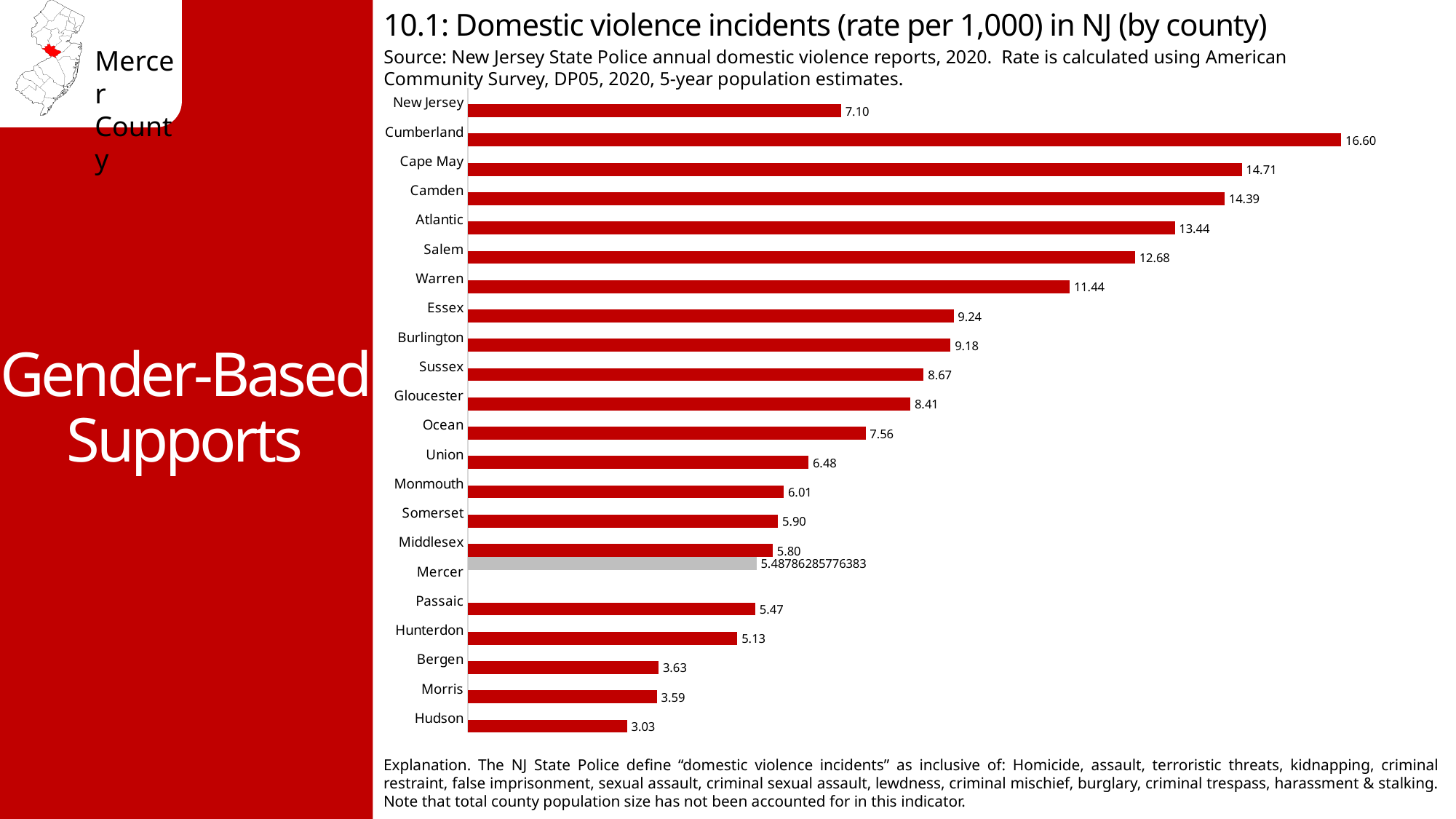
How many bars (counties plus the state total) are plotted in the chart? 22 What is the difference between the rates for Cape May and Camden? 0.32 Which has a higher domestic violence incident rate, Essex or Ocean? Essex What is the difference between the rates for Cumberland and Hudson? 13.57 Which county has the highest domestic violence incident rate in the chart? Cumberland Which bar in the chart is shaded grey instead of red? Mercer What is the domestic violence incident rate per 1,000 shown for New Jersey overall? 7.10 Which has a higher domestic violence incident rate, Warren or Salem? Salem Which county has the lowest domestic violence incident rate in the chart? Hudson What is the domestic violence incident rate per 1,000 for Cumberland County? 16.60 What is the domestic violence incident rate per 1,000 for Hunterdon County? 5.13 What type of chart is used to show domestic violence incident rates by county? Bar chart